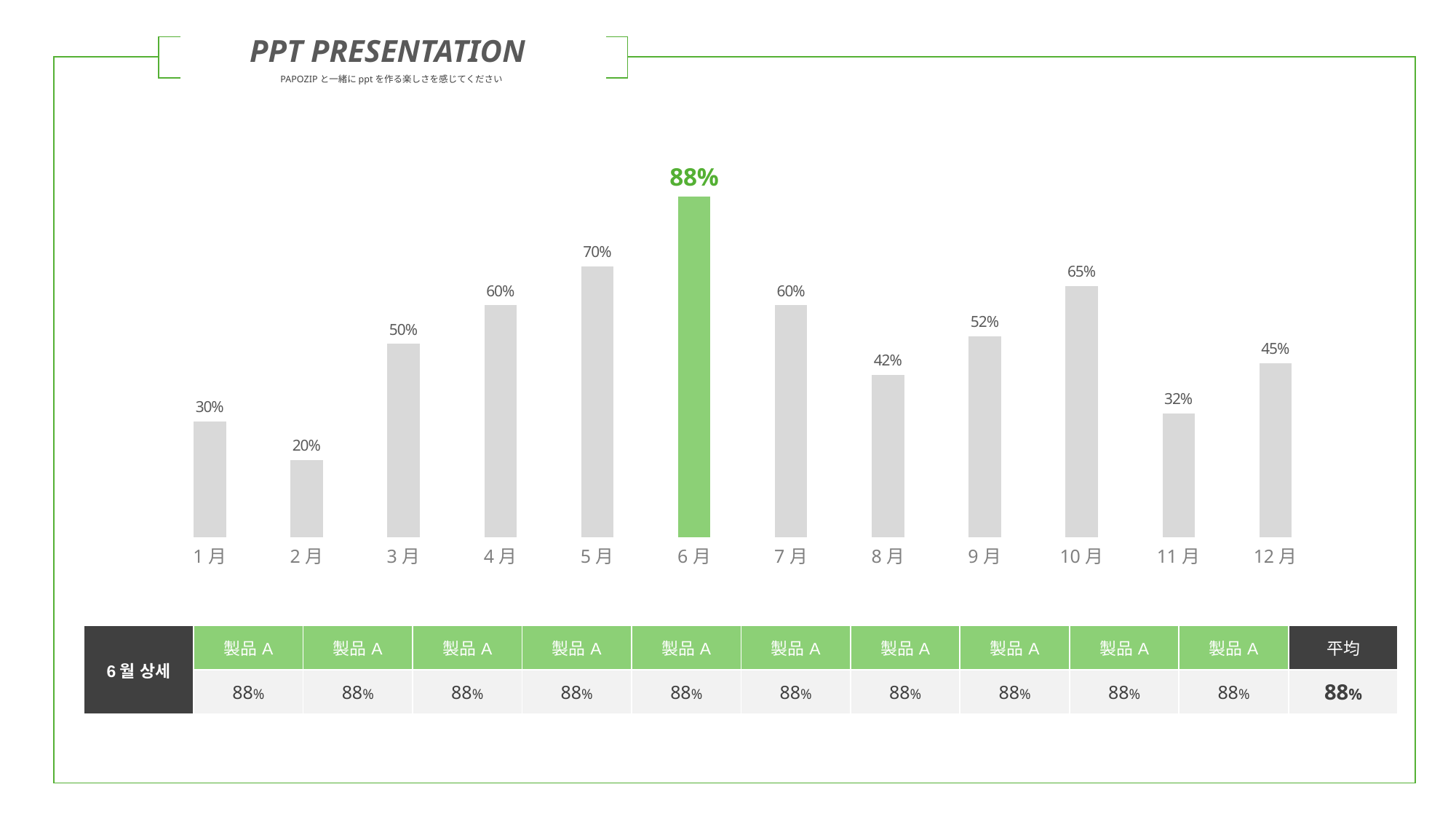
What is the difference between the values for 10月 and 11月? 33% What is the value for 2月? 20% What is the value for 6月? 88% Which bar is highlighted in green? 6月 Which month has the highest value? 6月 Do the values rise or fall from 1月 to 6月? rise Which is larger, the value for 9月 or the value for 8月? 9月 What kind of chart is shown on the slide? bar chart Which month has the lowest value? 2月 What is the value for 10月? 65% What is the difference between the values for 6月 and 5月? 18% How many months are shown on the x axis? 12